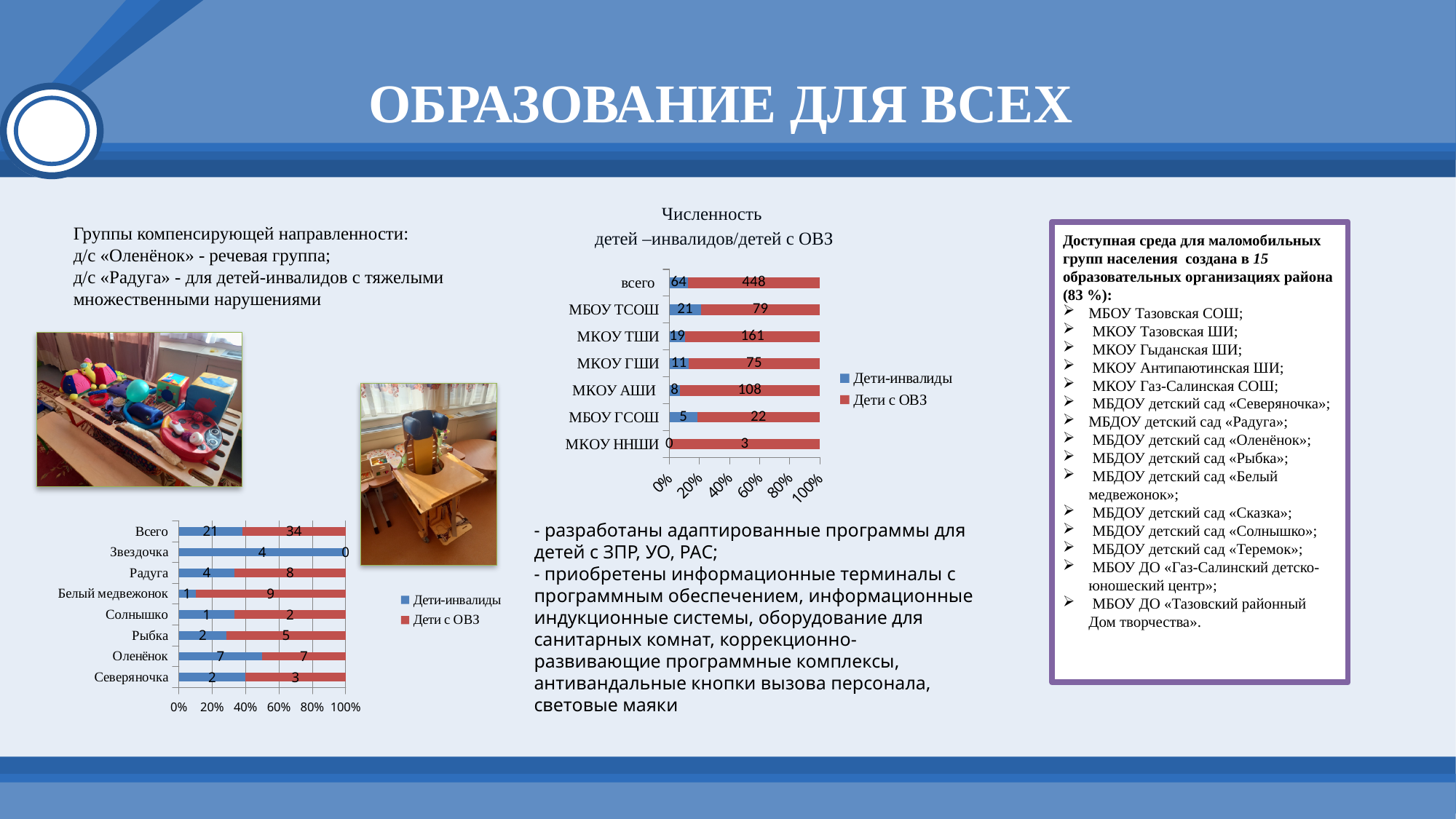
In the bottom-left chart, which is larger for Радуга: «Дети-инвалиды» or «Дети с ОВЗ»? Дети с ОВЗ In the chart titled «Численность детей –инвалидов/детей с ОВЗ», how many categories are shown on the vertical axis? 7 In the chart titled «Численность детей –инвалидов/детей с ОВЗ», what is the difference between the «Дети с ОВЗ» values for МКОУ АШИ and МКОУ ГШИ? 33 In the chart titled «Численность детей –инвалидов/детей с ОВЗ», which category has the lowest value for «Дети с ОВЗ»? МКОУ ННШИ In the chart titled «Численность детей –инвалидов/детей с ОВЗ», what is the value for «Дети с ОВЗ» for МКОУ ТШИ? 161 In the bottom-left chart, what is the value for «Дети с ОВЗ» for Белый медвежонок? 9 What kind of chart is the chart titled «Численность детей –инвалидов/детей с ОВЗ»? Stacked bar chart In the chart titled «Численность детей –инвалидов/детей с ОВЗ», what is the value for «Дети-инвалиды» for МБОУ ТСОШ? 21 In the chart titled «Численность детей –инвалидов/детей с ОВЗ», how many series does the legend list? 2 In the bottom-left chart, what is the total of the «Всего» bar («Дети-инвалиды» plus «Дети с ОВЗ»)? 55 In the bottom-left chart, what is the value for «Дети-инвалиды» for Оленёнок? 7 In the bottom-left chart, which colour represents «Дети-инвалиды»? Blue